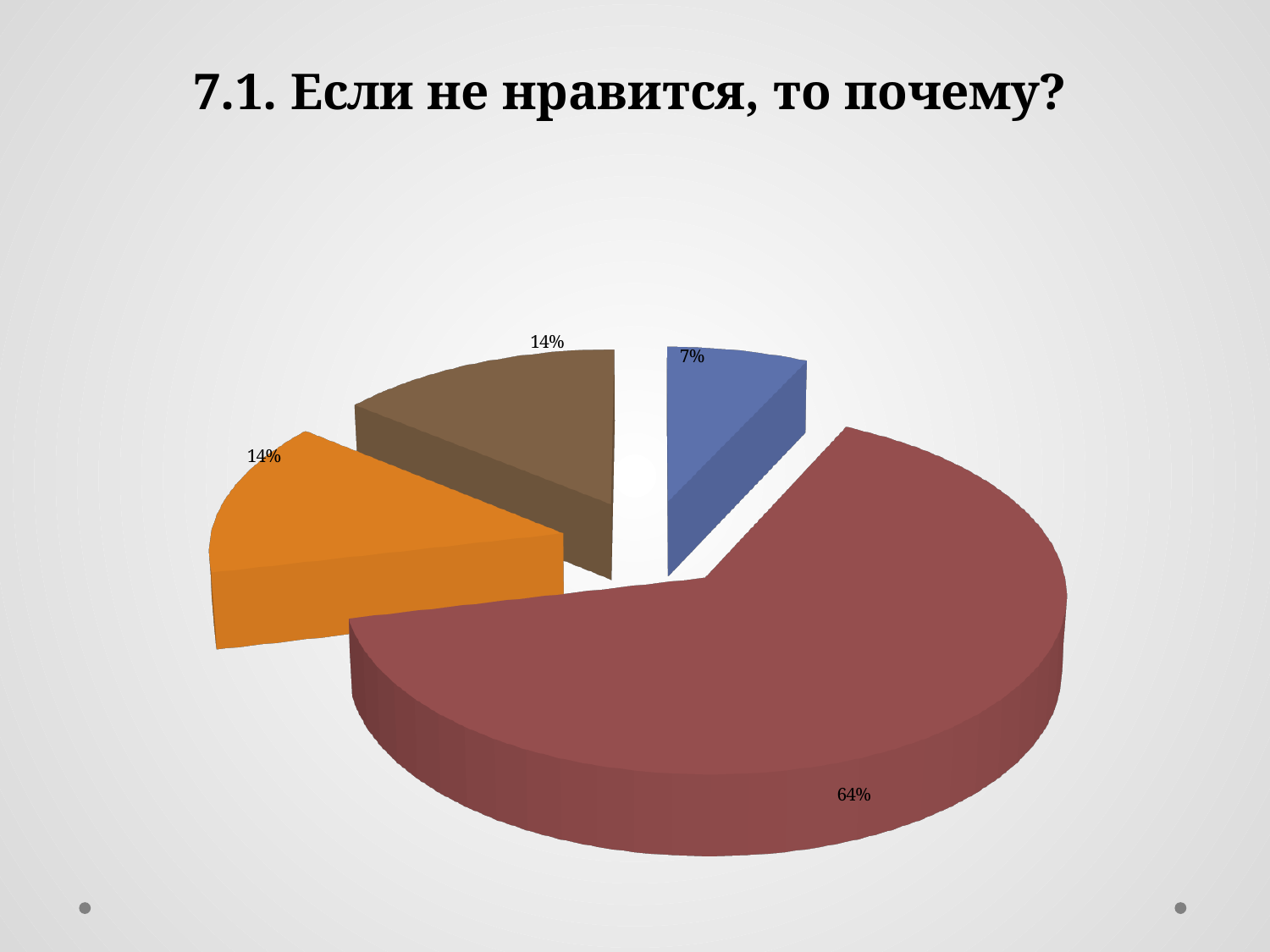
Which slice of the pie chart is the smallest? The blue slice (7%) What is the difference in percentage points between the red slice and the blue slice? 57 Is the value of the red slice greater or less than 50%? greater What percentage is shown for the blue slice of the pie chart? 7% Which is larger, the orange slice or the blue slice? The orange slice What percentage is shown for the brown slice of the pie chart? 14% How many slices does the pie chart have? 4 What is the title of the slide containing the pie chart? 7.1. Если не нравится, то почему? What percentage is shown for the red slice of the pie chart? 64% Which slice of the pie chart is the largest? The red slice (64%) What kind of chart is shown on the slide? Pie chart What percentage is shown for the orange slice of the pie chart? 14%